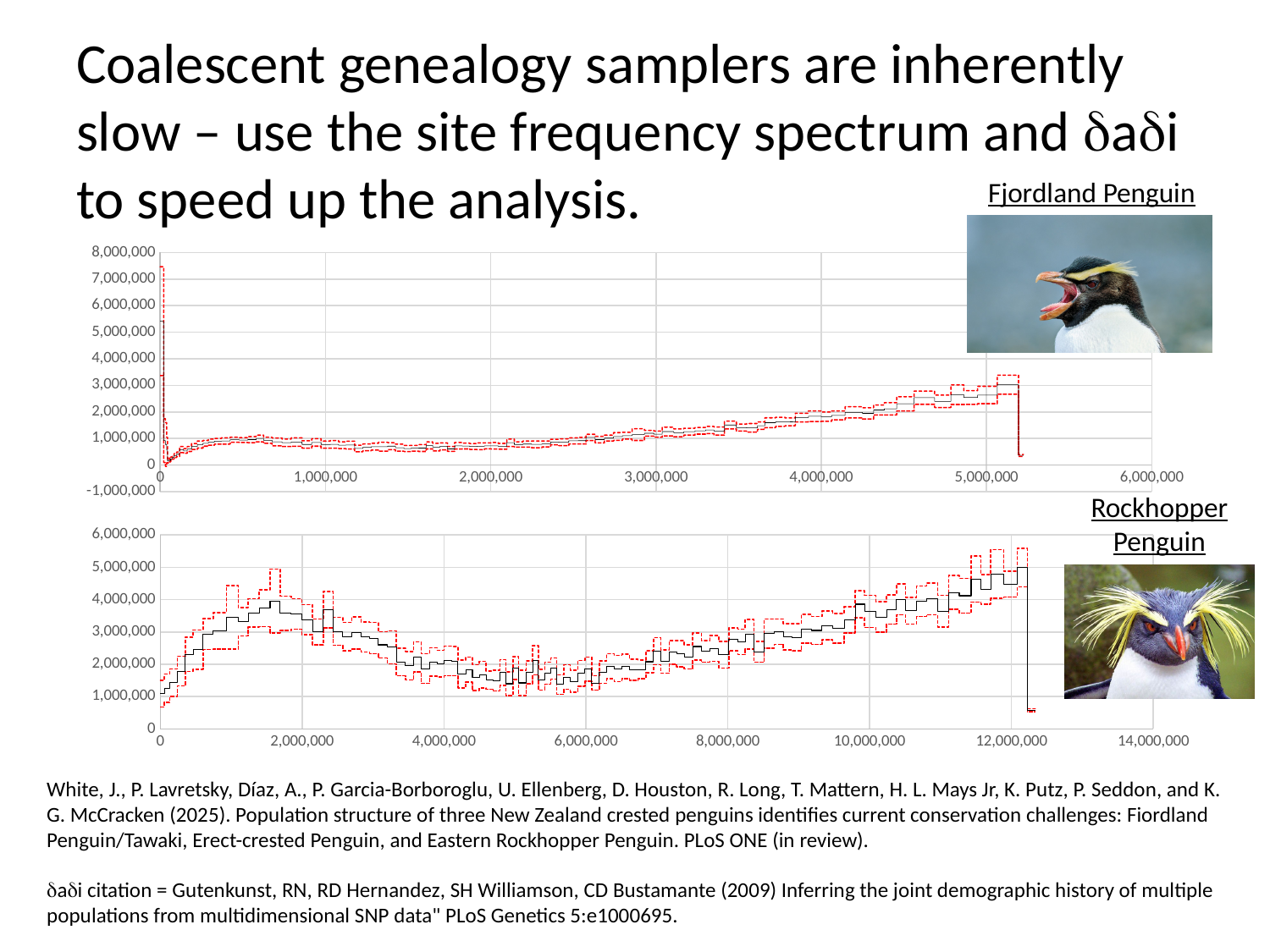
In the bottom chart, is the value of the solid black line at x = 2,000,000 greater or less than 3,000,000? greater In the top chart, is the value of the solid black line at x = 2,000,000 greater or less than 1,000,000? less What kind of chart is the bottom chart on the slide? line chart In the bottom chart, is the value of the solid black line at x = 6,000,000 greater or less than 2,000,000? less In the top chart, does the solid black line generally rise or fall between x = 1,000,000 and x = 5,000,000? rise What is the highest value shown on the y axis of the top chart? 8,000,000 In the bottom chart, does the solid black line generally rise or fall between x = 6,000,000 and x = 12,000,000? rise What is the highest value shown on the x axis of the bottom chart? 14,000,000 How many charts are shown on the slide? 2 What kind of chart is the top chart on the slide? line chart